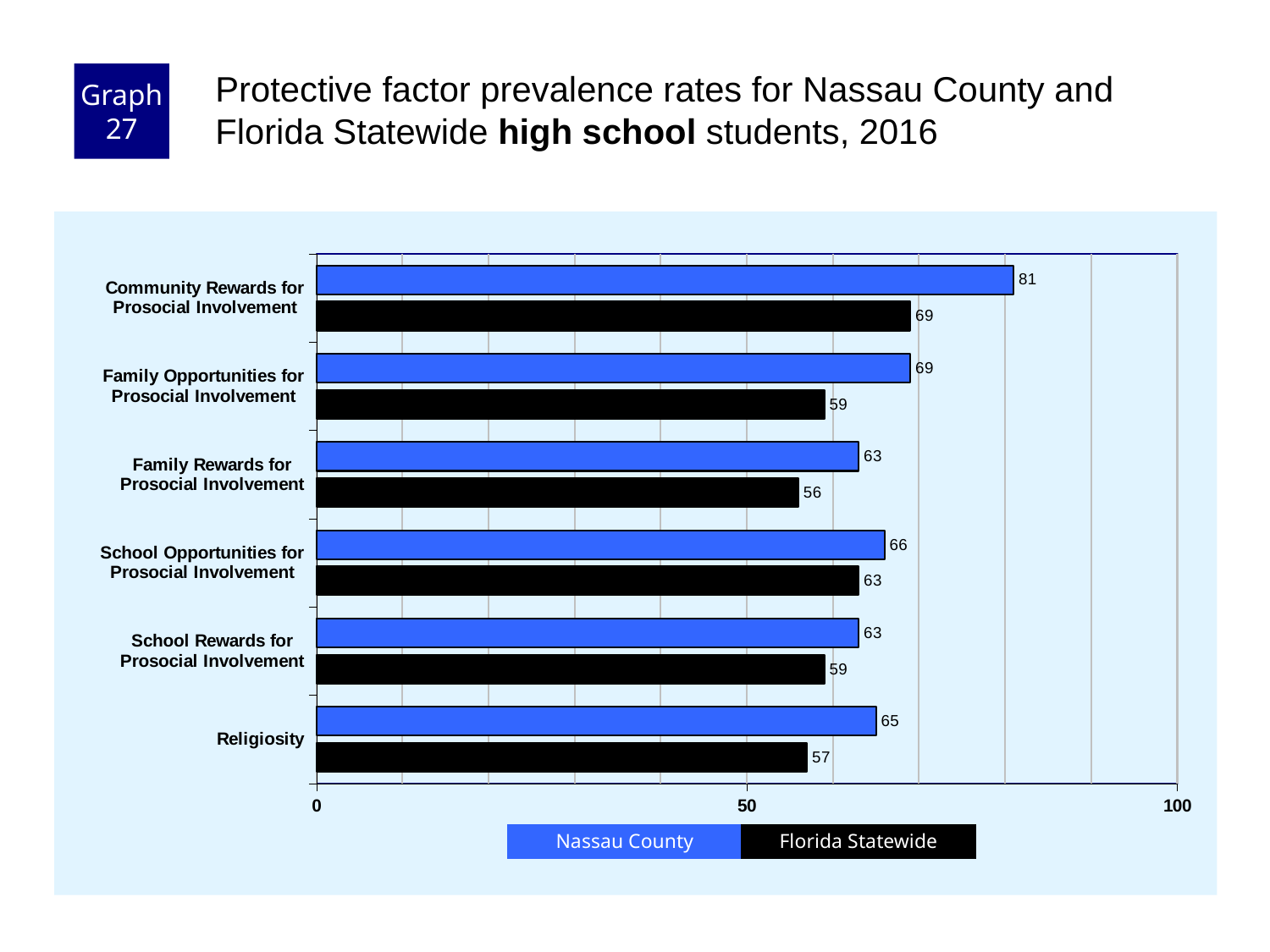
What is the difference between the Nassau County and Florida Statewide values for Religiosity? 8 What is the difference between the Nassau County and Florida Statewide values for Community Rewards for Prosocial Involvement? 12 What kind of chart is shown on the slide? Bar chart What is the Nassau County value for Religiosity? 65 Which is larger for School Opportunities for Prosocial Involvement, the Nassau County value or the Florida Statewide value? Nassau County Is the Florida Statewide value for Family Opportunities for Prosocial Involvement greater or less than 50? greater What is the Nassau County value for Community Rewards for Prosocial Involvement? 81 How many categories are shown on the chart? 6 Which category has the lowest Florida Statewide value? Family Rewards for Prosocial Involvement What is the Florida Statewide value for Family Rewards for Prosocial Involvement? 56 Which category has the highest Nassau County value? Community Rewards for Prosocial Involvement How many series does the legend list? 2